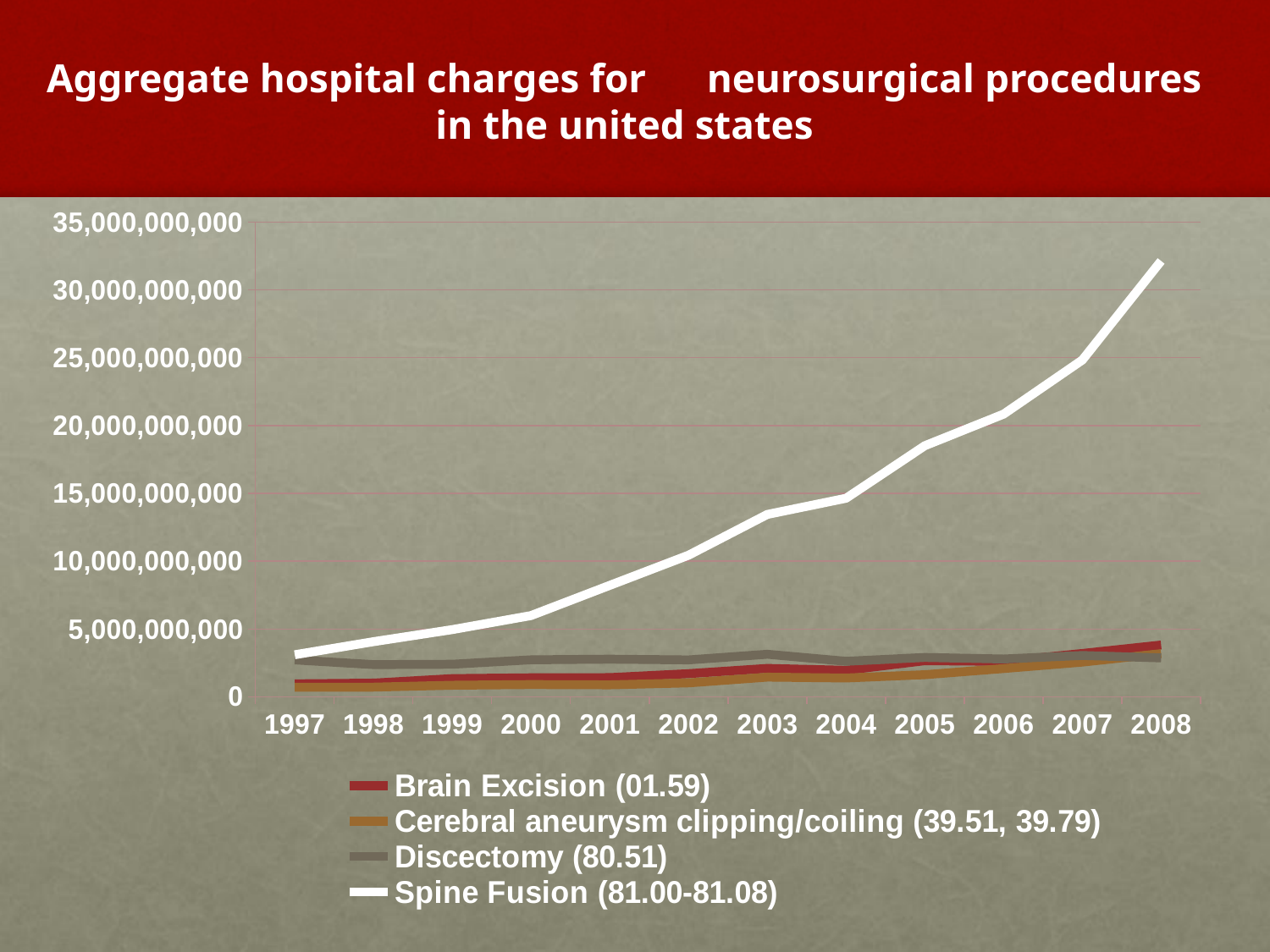
Does the Spine Fusion (81.00-81.08) series rise or fall from 1997 to 2008? rise Is the value for Spine Fusion (81.00-81.08) in 2001 greater or less than 10,000,000,000? less Is the value for Spine Fusion (81.00-81.08) in 2008 greater or less than 30,000,000,000? greater In 2008, which is larger: Spine Fusion (81.00-81.08) or Discectomy (80.51)? Spine Fusion (81.00-81.08) How many years are shown along the x axis? 12 What is the title of the chart on the slide? Aggregate hospital charges for neurosurgical procedures in the united states Is the value for Spine Fusion (81.00-81.08) in 2003 greater or less than 10,000,000,000? greater What kind of chart is shown on the slide? line chart Which series has the highest value in 2008? Spine Fusion (81.00-81.08) How many series does the legend list? 4